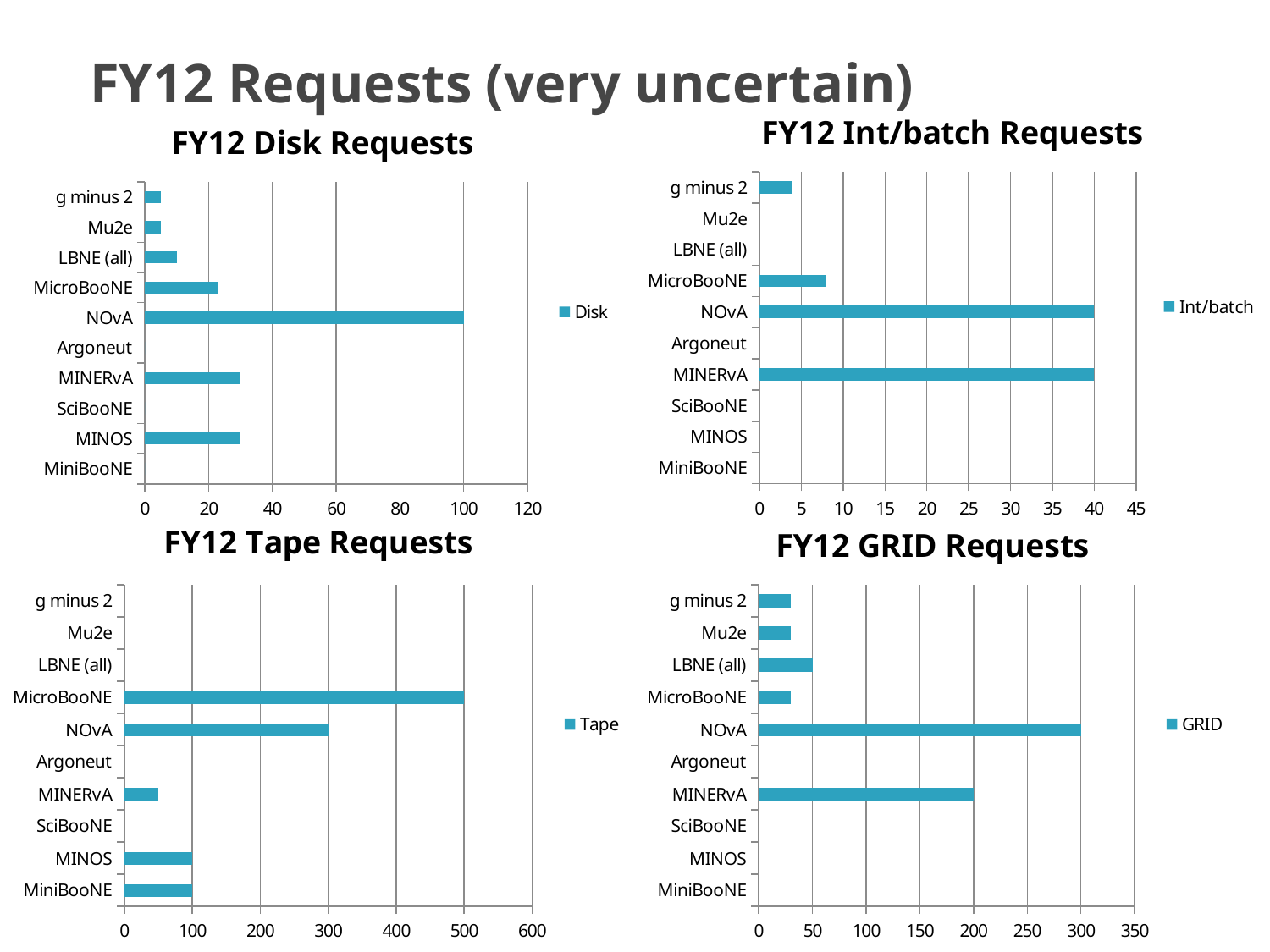
In the FY12 Tape Requests chart, what is the value for MicroBooNE? 500 In the FY12 Tape Requests chart, what is the value for NOvA? 300 In the FY12 Int/batch Requests chart, is the value for MicroBooNE greater or less than 5? greater How many categories are listed on the y axis of the FY12 Disk Requests chart? 10 In the FY12 Tape Requests chart, what is the difference between the values for MicroBooNE and NOvA? 200 In the FY12 GRID Requests chart, what is the value for MINERvA? 200 In the FY12 GRID Requests chart, which is larger, the value for NOvA or the value for MINERvA? NOvA How many series does the legend of the FY12 Disk Requests chart list? 1 What kind of chart is the FY12 Int/batch Requests chart? bar chart In the FY12 Disk Requests chart, which category has the highest value? NOvA In the FY12 Disk Requests chart, what is the value for NOvA? 100 In the FY12 Disk Requests chart, is the value for MINERvA greater or less than 20? greater